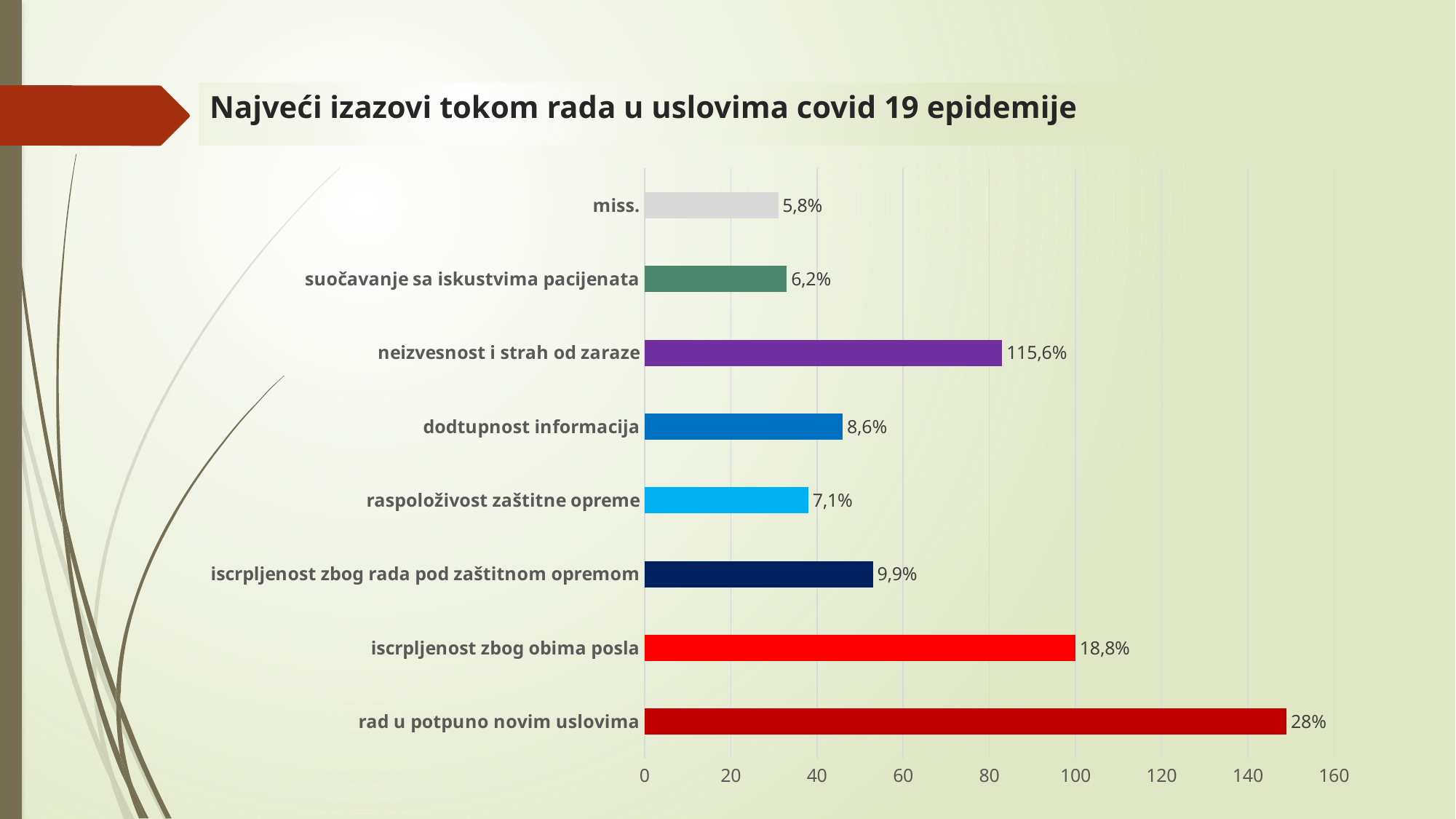
What is the data label shown for "rad u potpuno novim uslovima"? 28% How many categories are shown in the chart? 8 What is the data label shown for "raspoloživost zaštitne opreme"? 7,1% Is the bar for "rad u potpuno novim uslovima" greater or less than 140 on the axis? greater What is the data label shown for "iscrpljenost zbog obima posla"? 18,8% Which category has the longest bar? rad u potpuno novim uslovima Is the bar for "dodtupnost informacija" greater or less than 40 on the axis? greater What is the title of the slide? Najveći izazovi tokom rada u uslovima covid 19 epidemije Which bar is longer: "iscrpljenost zbog obima posla" or "iscrpljenost zbog rada pod zaštitnom opremom"? iscrpljenost zbog obima posla Which category has the shortest bar? miss. What kind of chart is shown on the slide? bar chart What is the data label shown for "miss."? 5,8%